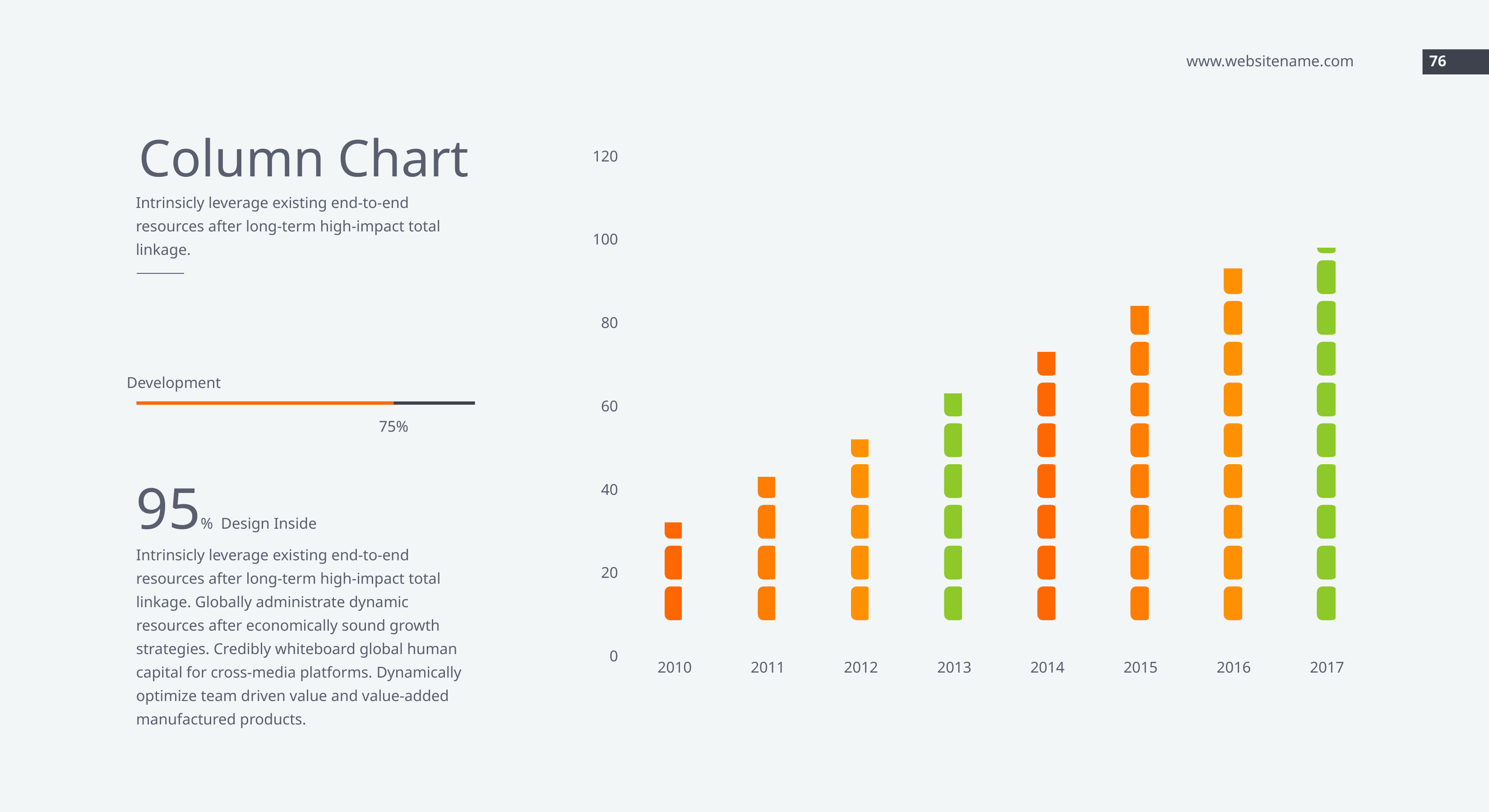
Is the value for 2016 greater or less than 100? less Which year has the lowest bar in the chart? 2010 How many years are shown on the x axis of the chart? 8 Which year has the highest bar in the chart? 2017 Which is larger, the value for 2013 or the value for 2015? 2015 Is the value for 2012 greater or less than 60? less What is the highest value labelled on the chart's vertical axis? 120 Is the value for 2014 greater or less than 60? greater What is the title of the slide containing the chart? Column Chart What kind of chart is shown on the slide? bar chart Do the bar values rise or fall from 2010 to 2017? rise